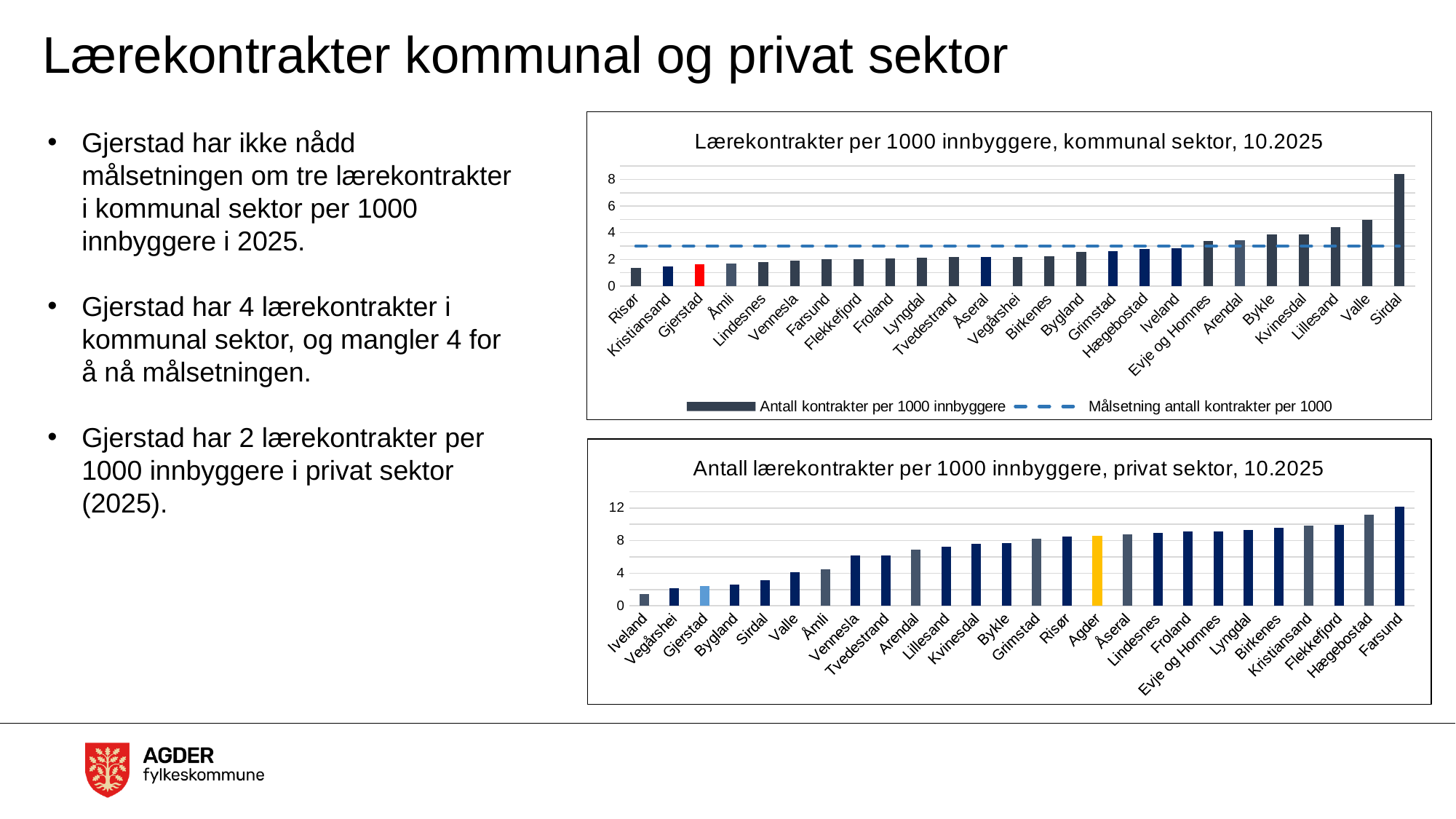
In the chart 'Lærekontrakter per 1000 innbyggere, kommunal sektor, 10.2025', which municipality has the highest value? Sirdal In the chart 'Antall lærekontrakter per 1000 innbyggere, privat sektor, 10.2025', which municipality has the lowest value? Iveland In the chart 'Antall lærekontrakter per 1000 innbyggere, privat sektor, 10.2025', which municipality has the highest value? Farsund In the chart 'Lærekontrakter per 1000 innbyggere, kommunal sektor, 10.2025', which municipality has the lowest value? Risør In the chart 'Lærekontrakter per 1000 innbyggere, kommunal sektor, 10.2025', is the value for Sirdal greater or less than 6? greater In the chart 'Lærekontrakter per 1000 innbyggere, kommunal sektor, 10.2025', is the value for Gjerstad greater or less than 2? less In the chart 'Lærekontrakter per 1000 innbyggere, kommunal sektor, 10.2025', how many municipalities are shown on the x axis? 25 What kind of chart is 'Antall lærekontrakter per 1000 innbyggere, privat sektor, 10.2025'? bar chart In the chart 'Antall lærekontrakter per 1000 innbyggere, privat sektor, 10.2025', is the value for Farsund greater or less than 8? greater In the chart 'Antall lærekontrakter per 1000 innbyggere, privat sektor, 10.2025', do the values rise or fall from left to right along the x axis? rise In the chart 'Lærekontrakter per 1000 innbyggere, kommunal sektor, 10.2025', which municipality's bar is coloured red? Gjerstad How many entries does the legend of the chart 'Lærekontrakter per 1000 innbyggere, kommunal sektor, 10.2025' list? 2